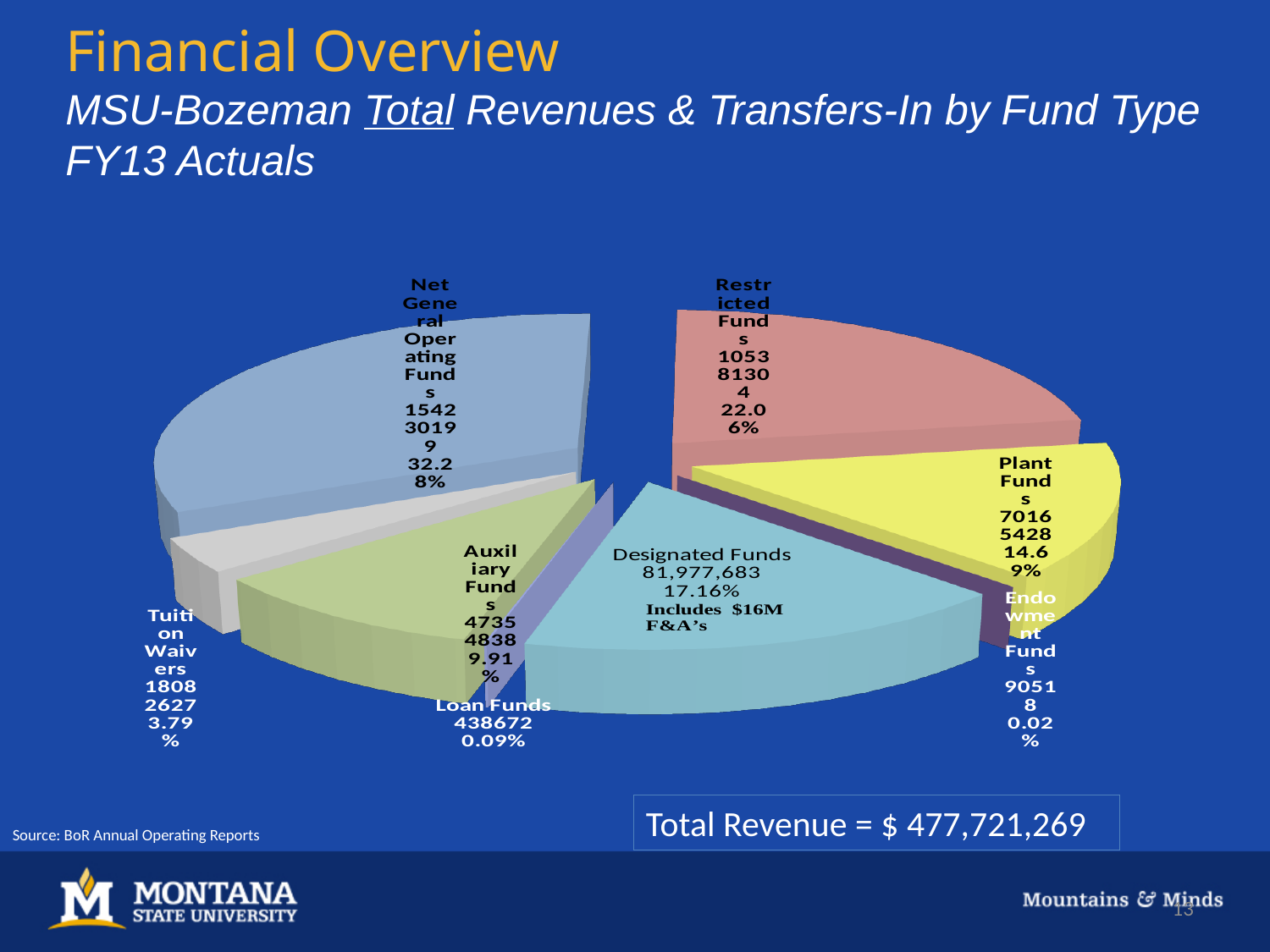
Which fund type has the smallest share of the pie? Endowment Funds What is the value shown for Loan Funds? 438672 What is the value shown for Designated Funds? 81,977,683 What total revenue figure is stated below the chart? $ 477,721,269 What percentage share of total revenue do Net General Operating Funds represent? 32.28% Which is larger, the share for Auxiliary Funds or the share for Tuition Waivers? Auxiliary Funds What percentage share is shown for Plant Funds? 14.69% What is the value shown for Restricted Funds? 105381304 What is the difference in percentage points between the Restricted Funds share (22.06%) and the Designated Funds share (17.16%)? 4.9 percentage points How many fund types (slices) does the pie chart show? 8 Which fund type has the largest share of the pie? Net General Operating Funds What kind of chart is shown on the slide? Pie chart